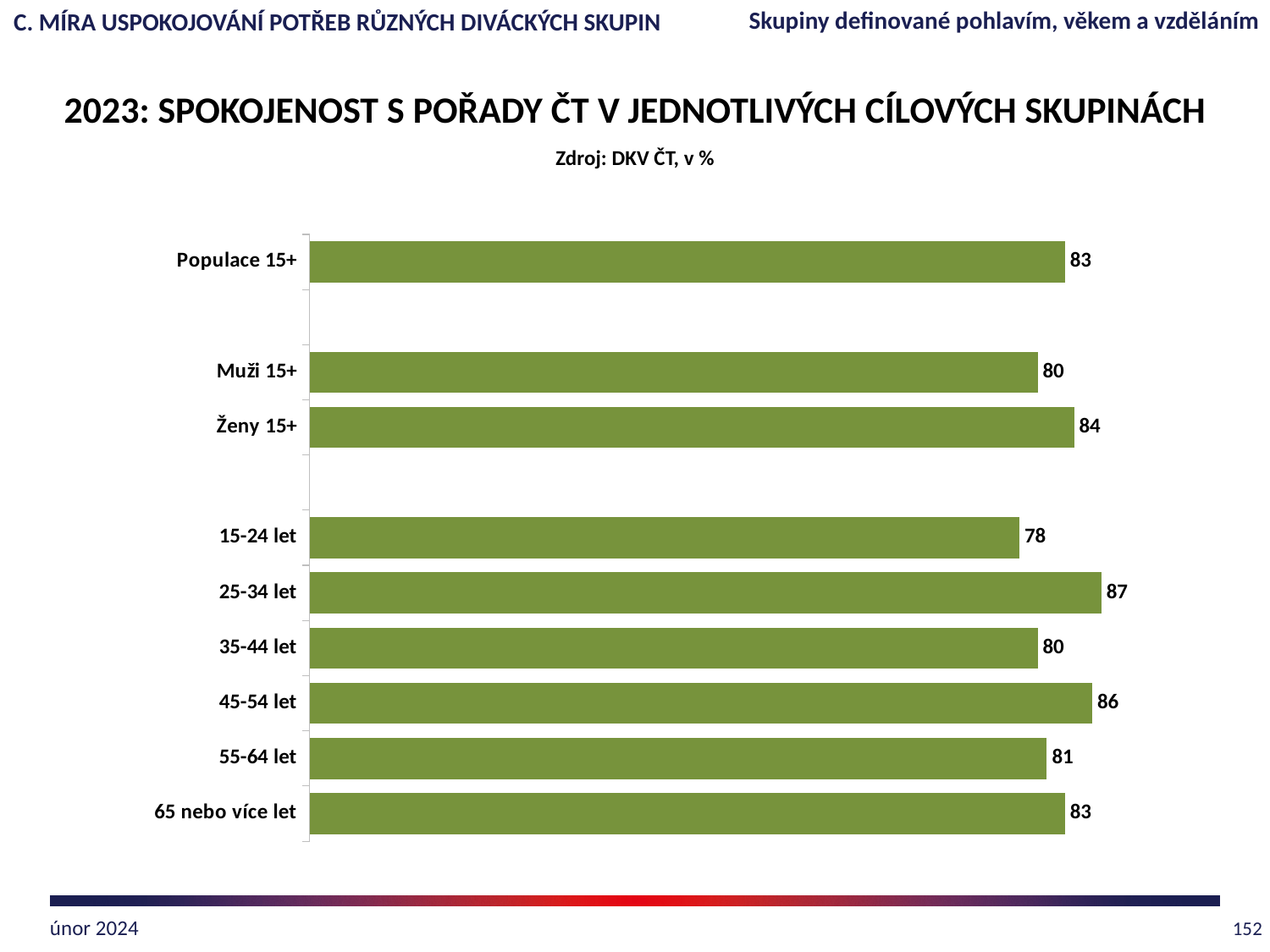
How many categories are shown in the chart? 9 What is the value for 15-24 let? 78 What is the difference between the values for 25-34 let and 15-24 let? 9 What is the value for Populace 15+? 83 What is the source noted under the chart title? DKV ČT, v % What is the value for 55-64 let? 81 What kind of chart is shown on the slide? bar chart What is the difference between the values for Ženy 15+ and Muži 15+? 4 Which is larger, the value for 45-54 let or the value for 35-44 let? 45-54 let Which category has the highest value? 25-34 let Which category has the lowest value? 15-24 let What is the value for Ženy 15+? 84